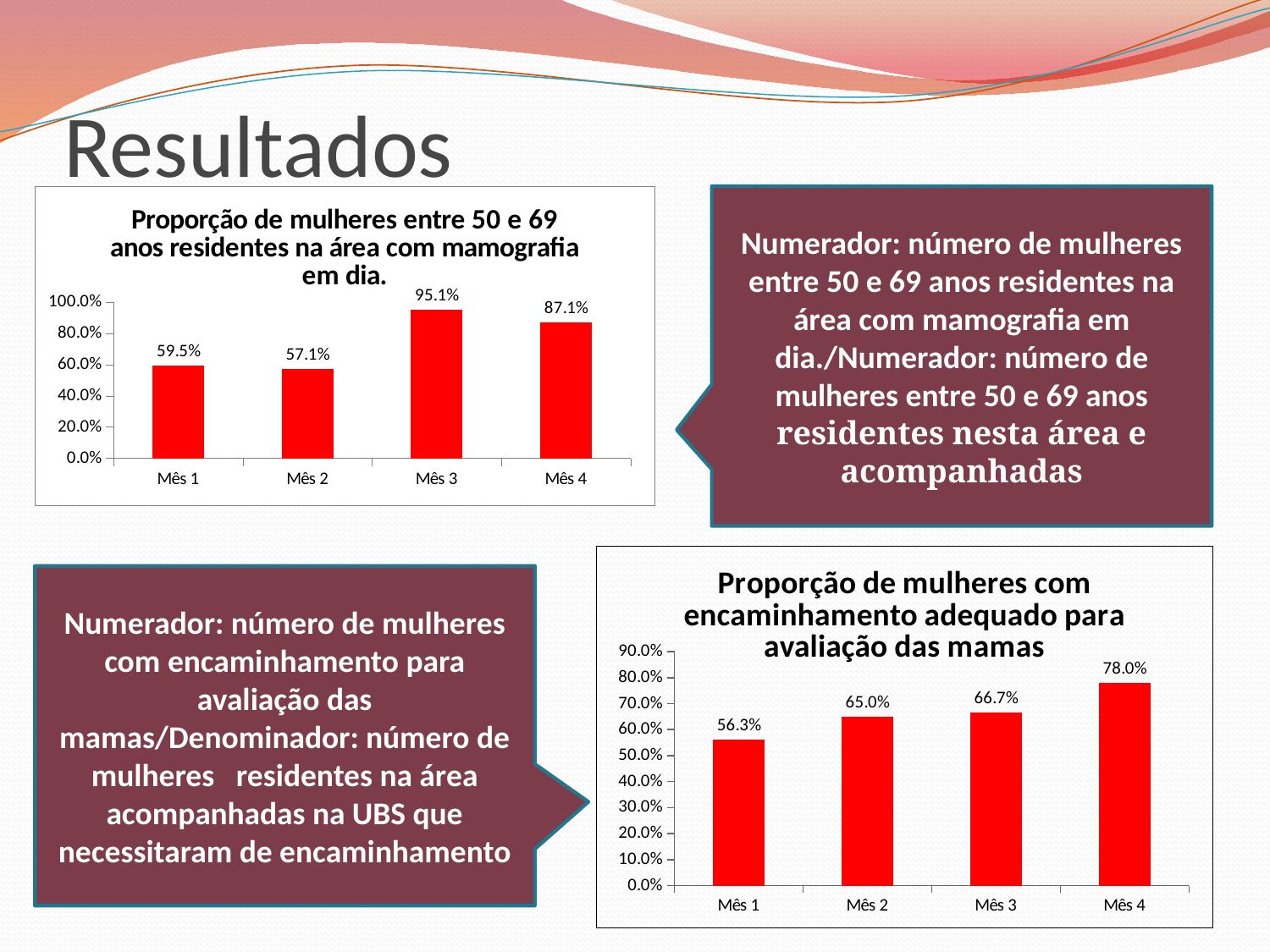
What kind of chart is the top-left chart (mamografia em dia)? bar chart In the bottom-right chart (encaminhamento adequado), which month has the highest value? Mês 4 In the top-left chart (mamografia em dia), which month has the highest value? Mês 3 In the bottom-right chart (encaminhamento adequado), what is the difference between Mês 4 and Mês 1? 21.7% In the top-left chart (mamografia em dia), how many months are plotted? 4 In the bottom-right chart (encaminhamento adequado), do the values rise or fall from Mês 1 to Mês 4? rise In the bottom-right chart (encaminhamento adequado), what is the value for Mês 4? 78.0% In the top-left chart (Proporção de mulheres entre 50 e 69 anos residentes na área com mamografia em dia), what is the value for Mês 3? 95.1% In the bottom-right chart (Proporção de mulheres com encaminhamento adequado para avaliação das mamas), what is the value for Mês 1? 56.3% In the bottom-right chart (encaminhamento adequado), is the value for Mês 2 larger or smaller than the value for Mês 3? smaller In the top-left chart (mamografia em dia), which month has the lowest value? Mês 2 In the top-left chart (mamografia em dia), what is the difference between Mês 3 and Mês 4? 8.0%